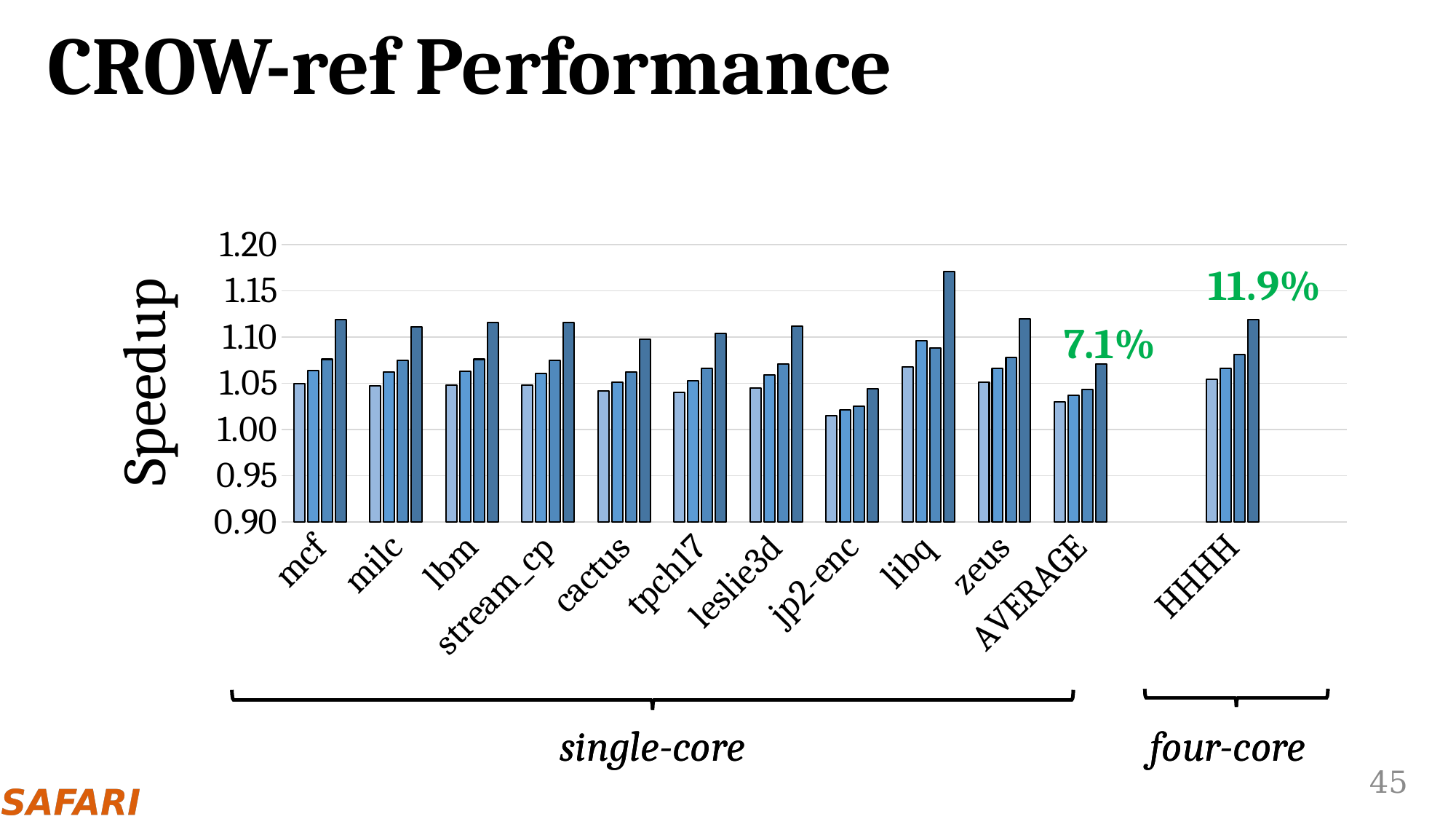
What is the label of the y axis? Speedup Is the tallest bar for jp2-enc greater or less than 1.05? less Which category is larger in its tallest bar, libq or cactus? libq What percentage is annotated above the AVERAGE bars? 7.1% Which category contains the tallest bar in the chart? libq Which category is grouped under the 'four-core' bracket? HHHH What percentage is annotated above the HHHH bars? 11.9% Is the tallest bar for libq greater or less than 1.15? greater What type of chart is shown on the slide? bar chart Is the tallest bar for mcf greater or less than 1.10? greater How many categories are shown along the x axis of the chart? 12 Which category has the lowest speedup bars? jp2-enc